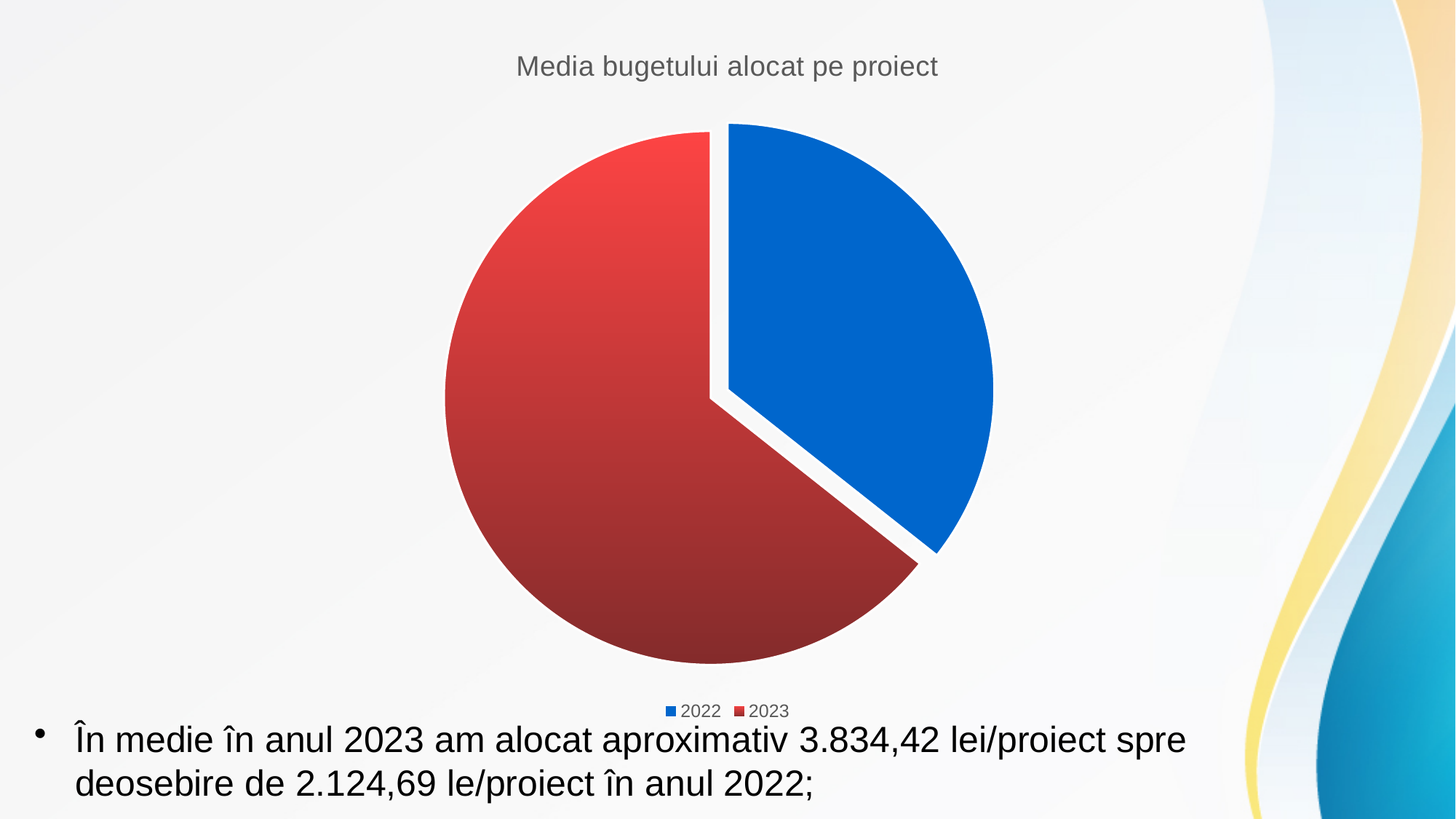
What is the title of the chart? Media bugetului alocat pe proiect Which year has the largest slice of the pie? 2023 How many entries does the legend list? 2 Which colour represents 2022 in the pie chart? blue Is the slice for 2023 more or less than half of the pie? more What kind of chart is shown on the slide? pie chart Which year has the smallest slice of the pie? 2022 How many slices does the pie chart have? 2 Which slice is larger, 2022 or 2023? 2023